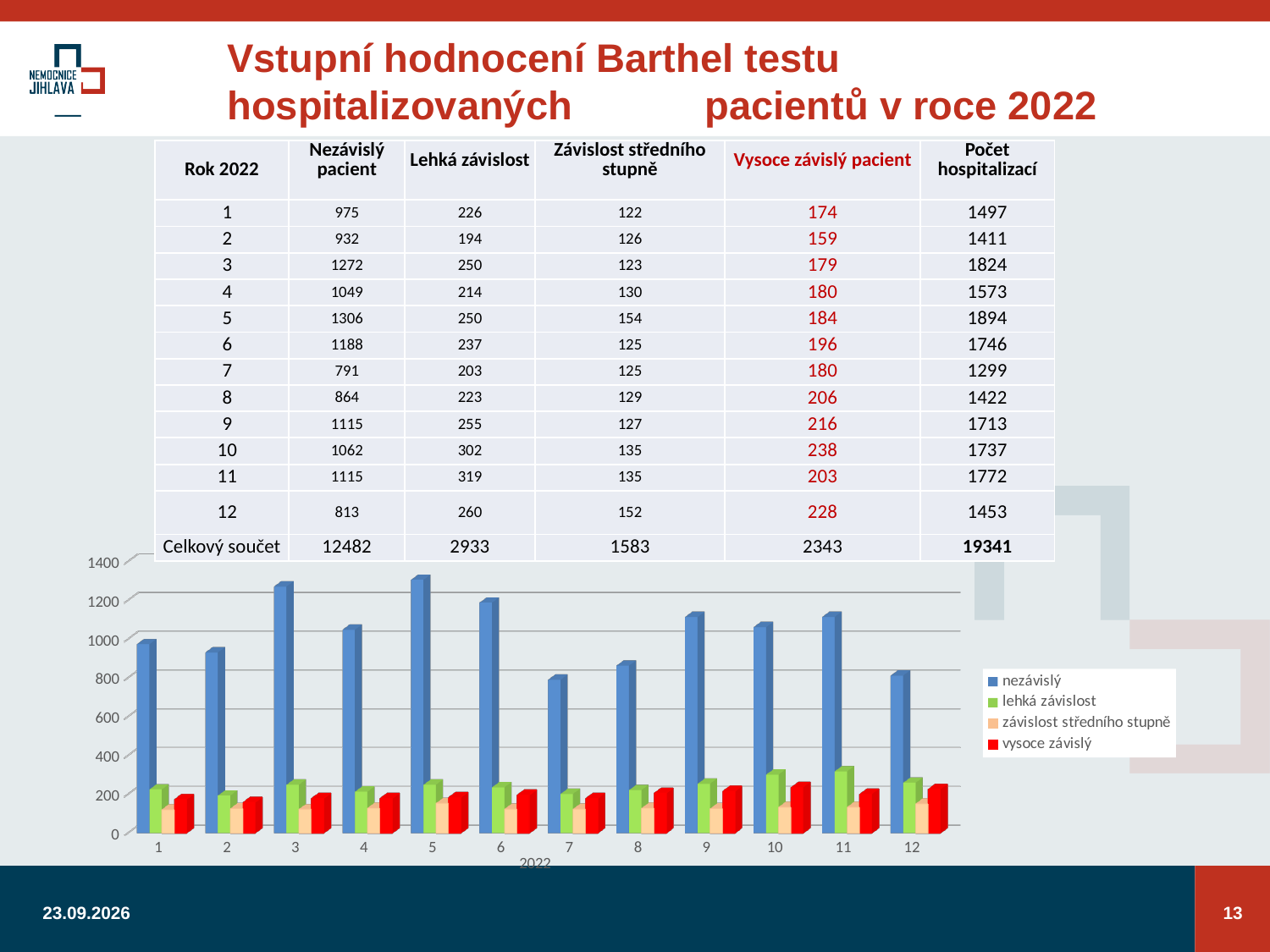
What colour represents the series vysoce závislý in the chart legend? red How many series does the chart legend list? 4 Using the table values, what is the difference between the Nezávislý pacient values for month 1 and month 2? 43 What kind of chart is shown at the bottom of the slide? bar chart How many categories (months) are shown along the x axis of the chart? 12 According to the table, what is the Vysoce závislý pacient value for month 10? 238 According to the table, which month has the highest Nezávislý pacient value? 5 According to the table, what is the Nezávislý pacient value for month 5? 1306 In the chart, is the value for nezávislý in month 7 greater or less than 1000? less In the chart, which month has the larger nezávislý value, month 3 or month 7? month 3 Do the lehká závislost values rise or fall from month 9 to month 11? rise In the chart, is the value for nezávislý in month 3 greater or less than 1200? greater